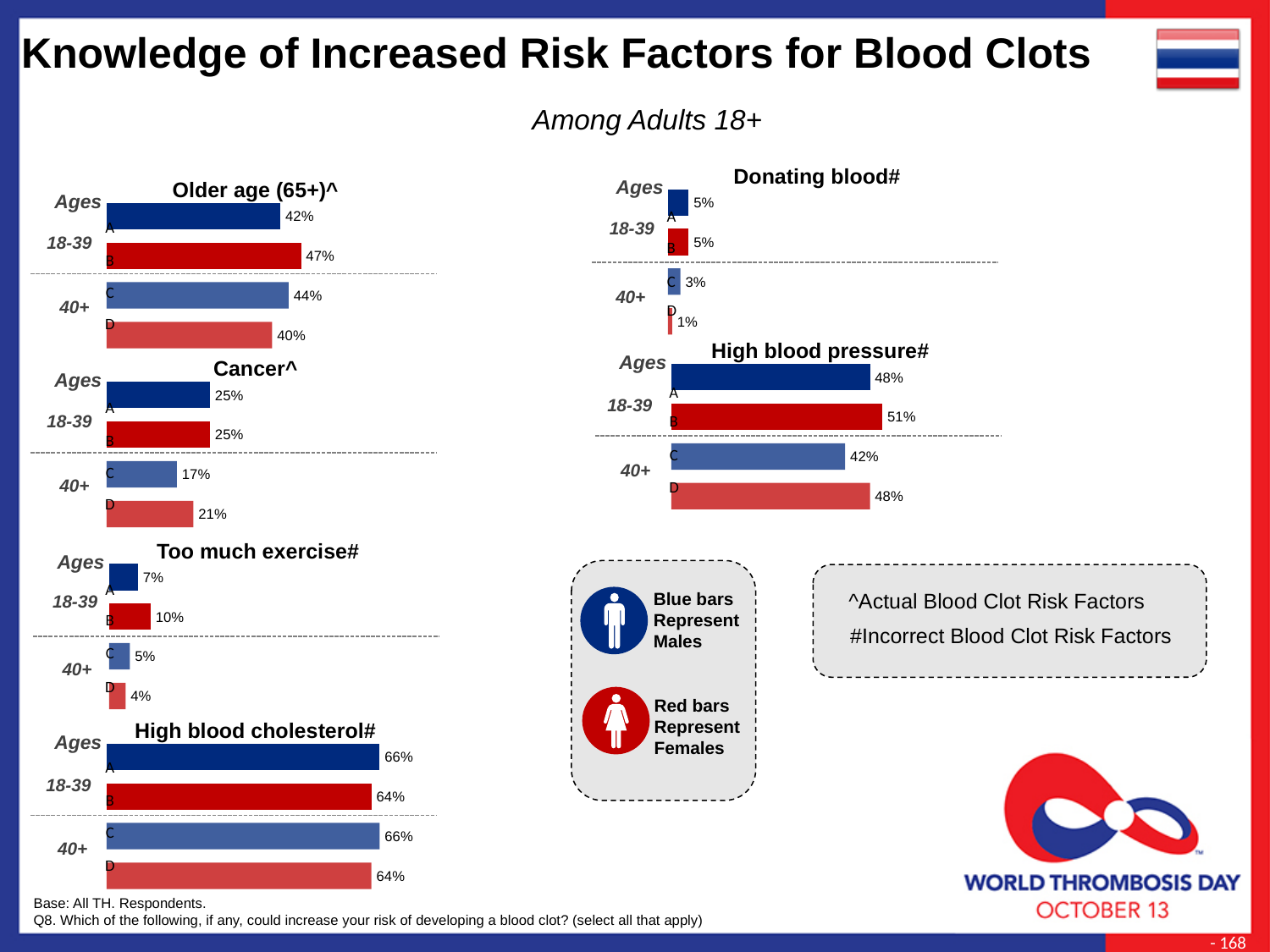
In the 'High blood pressure#' chart, which is larger: bar B (females 18-39) or bar C (males 40+)? B (females 18-39), 51% In the 'Older age (65+)^' chart, what is the value for females aged 18-39 (bar B)? 47% What type of chart is used for 'High blood cholesterol#'? Bar chart In the 'Too much exercise#' chart, which bar has the highest value? B (females 18-39), 10% In the 'High blood pressure#' chart, what is the difference between bar B (females 18-39) and bar A (males 18-39)? 3% In the 'Too much exercise#' chart, what is the value for females aged 40+ (bar D)? 4% In the 'High blood cholesterol#' chart, what is the value for males aged 18-39 (bar A)? 66% In the 'Donating blood#' chart, what is the value for females aged 40+ (bar D)? 1% In the 'Cancer^' chart, what is the difference between bar D (females 40+) and bar C (males 40+)? 4% In the 'Older age (65+)^' chart, which bar has the lowest value? D (females 40+), 40% In the 'Cancer^' chart, what is the value for males aged 40+ (bar C)? 17% How many bars does the 'Donating blood#' chart show? 4